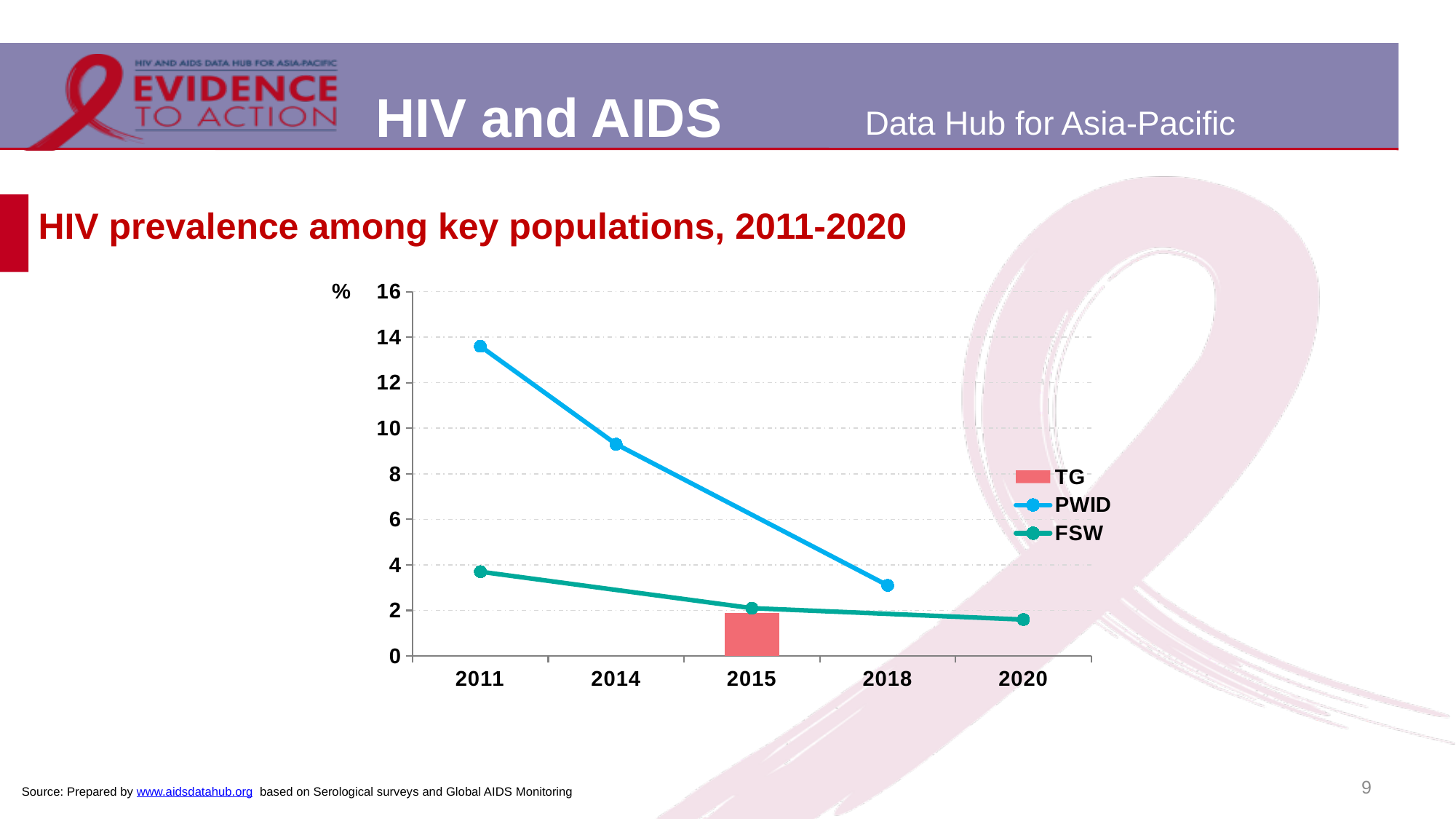
In which year is the PWID value highest? 2011 How many series does the legend list? 3 How many years are shown on the x axis? 5 In 2011, which is larger, the PWID value or the FSW value? PWID Is the PWID value for 2014 greater or less than 10? less Does the PWID line rise or fall from 2011 to 2018? fall Is the PWID value for 2018 greater or less than 4? less Does the FSW line rise or fall from 2011 to 2020? fall Is the PWID value for 2011 greater or less than 12? greater What kind of chart is shown on the slide? line and bar chart What are the series names listed in the legend? TG, PWID, FSW